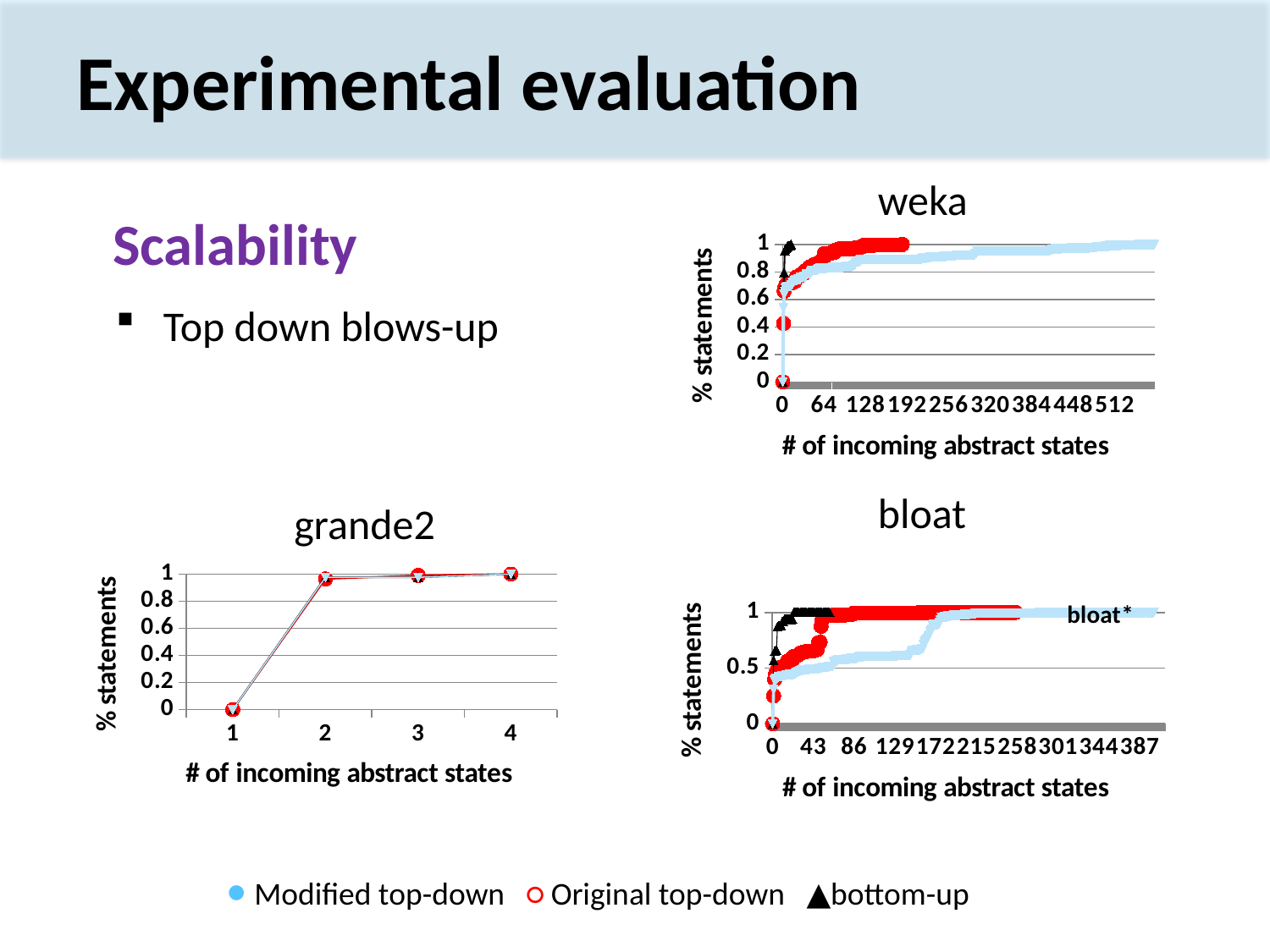
In the grande2 chart, do the values rise or fall as # of incoming abstract states increases from 1 to 4? rise What kind of chart is the weka chart? line chart In the grande2 chart, how many values of # of incoming abstract states are marked on the x axis? 4 What is the x-axis label of the bloat chart? # of incoming abstract states How many series does the legend at the bottom of the slide list? 3 In the grande2 chart, what is the % statements value at 4 incoming abstract states? 1 In the weka chart, is the Original top-down value at 64 incoming abstract states greater or less than 0.8? greater In the grande2 chart, is the % statements value at 2 incoming abstract states greater or less than 0.8? greater In the weka chart, which series extends to the largest # of incoming abstract states? Modified top-down What are the three series named in the legend? Modified top-down, Original top-down, bottom-up In the bloat chart, is the Original top-down value at 43 incoming abstract states greater or less than 0.5? greater In the grande2 chart, what is the % statements value at 1 incoming abstract state? 0